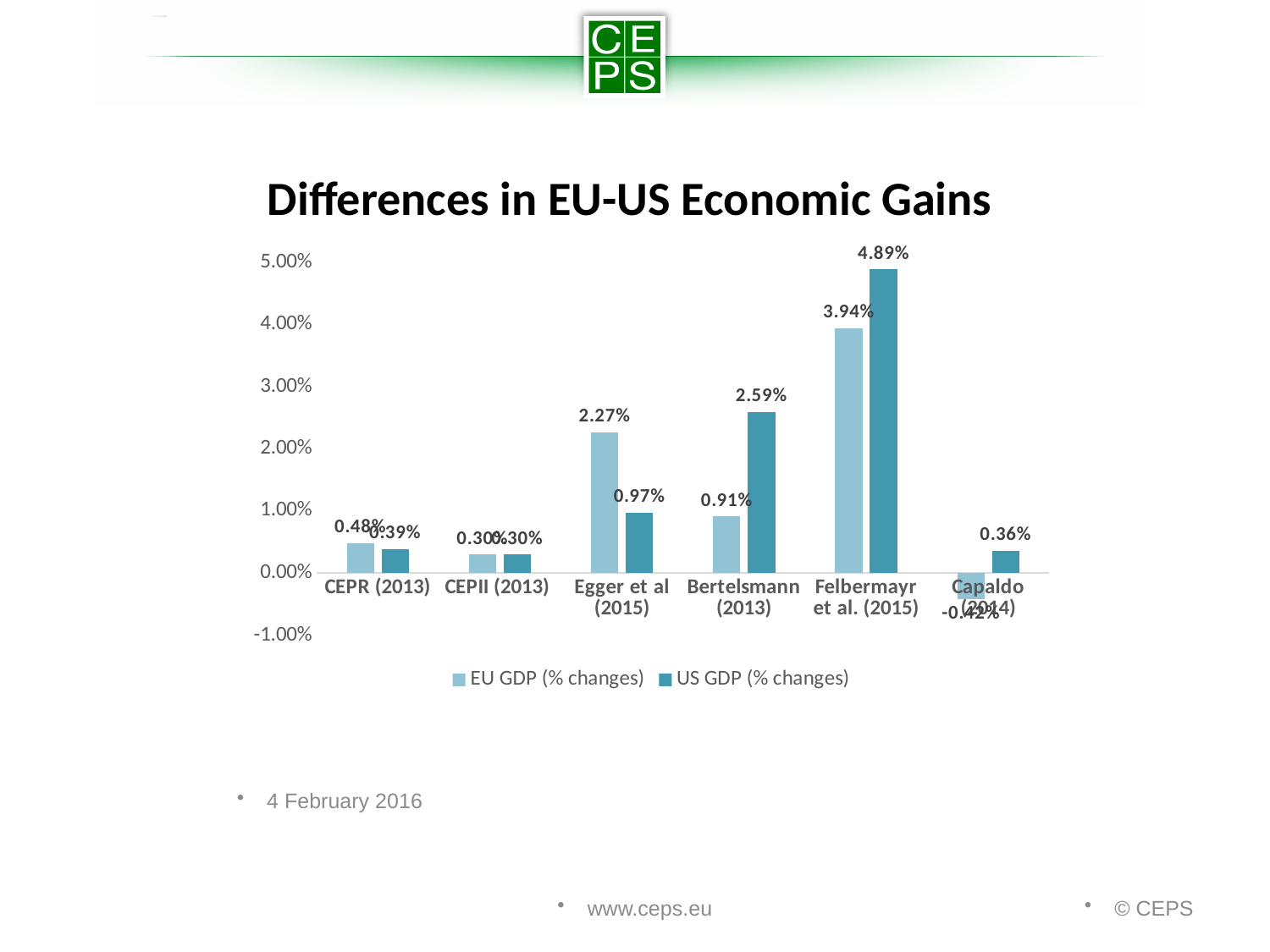
How many series does the legend list? 2 What is the EU GDP (% changes) value for Egger et al (2015)? 2.27% For Bertelsmann (2013), which is larger: the EU GDP value or the US GDP value? US GDP (% changes) What is the difference between the EU GDP and US GDP values for Egger et al (2015)? 1.30% What kind of chart is shown on the slide? bar chart Which study has the lowest EU GDP (% changes) value? Capaldo (2014) What is the US GDP (% changes) value for Bertelsmann (2013)? 2.59% What is the US GDP (% changes) value for Felbermayr et al. (2015)? 4.89% What is the difference between the US GDP and EU GDP values for Felbermayr et al. (2015)? 0.95% Which study has the highest US GDP (% changes) value? Felbermayr et al. (2015) Is the EU GDP (% changes) value for Felbermayr et al. (2015) greater or less than 3.00%? greater How many studies are shown on the x axis? 6